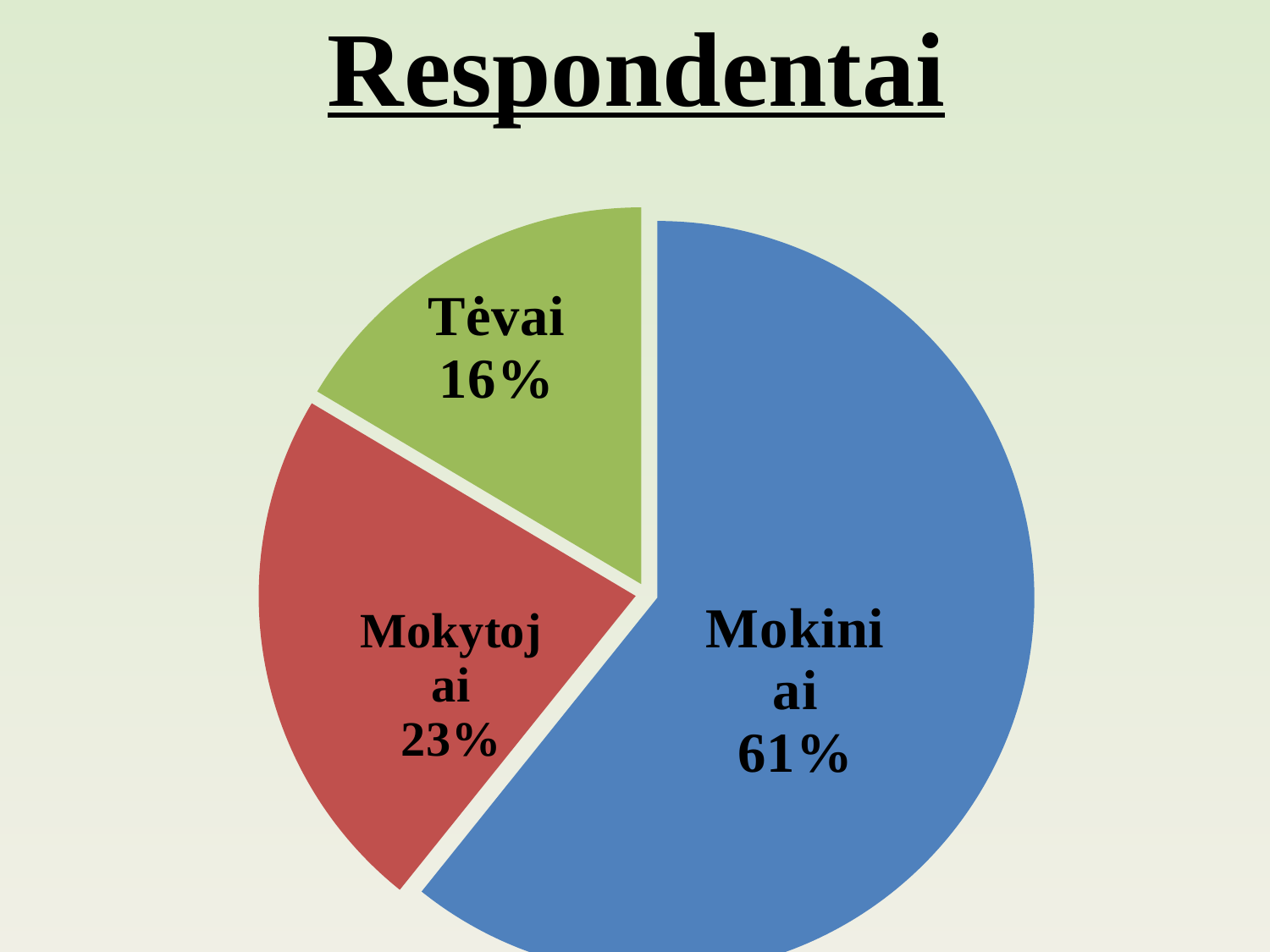
What share of respondents are Mokytojai? 23% What is the difference in percentage points between the Mokiniai and Mokytojai shares? 38 What is the difference in percentage points between the Mokytojai and Tėvai shares? 7 What type of chart is shown on the slide? pie chart What share of respondents are Tėvai? 16% What is the title of the chart? Respondentai How many slices does the pie chart have? 3 What colour is the Mokiniai slice? blue Which group has the largest share of respondents? Mokiniai Which group has the smallest share of respondents? Tėvai What share of respondents are Mokiniai? 61% Which share is larger, Mokytojai or Tėvai? Mokytojai